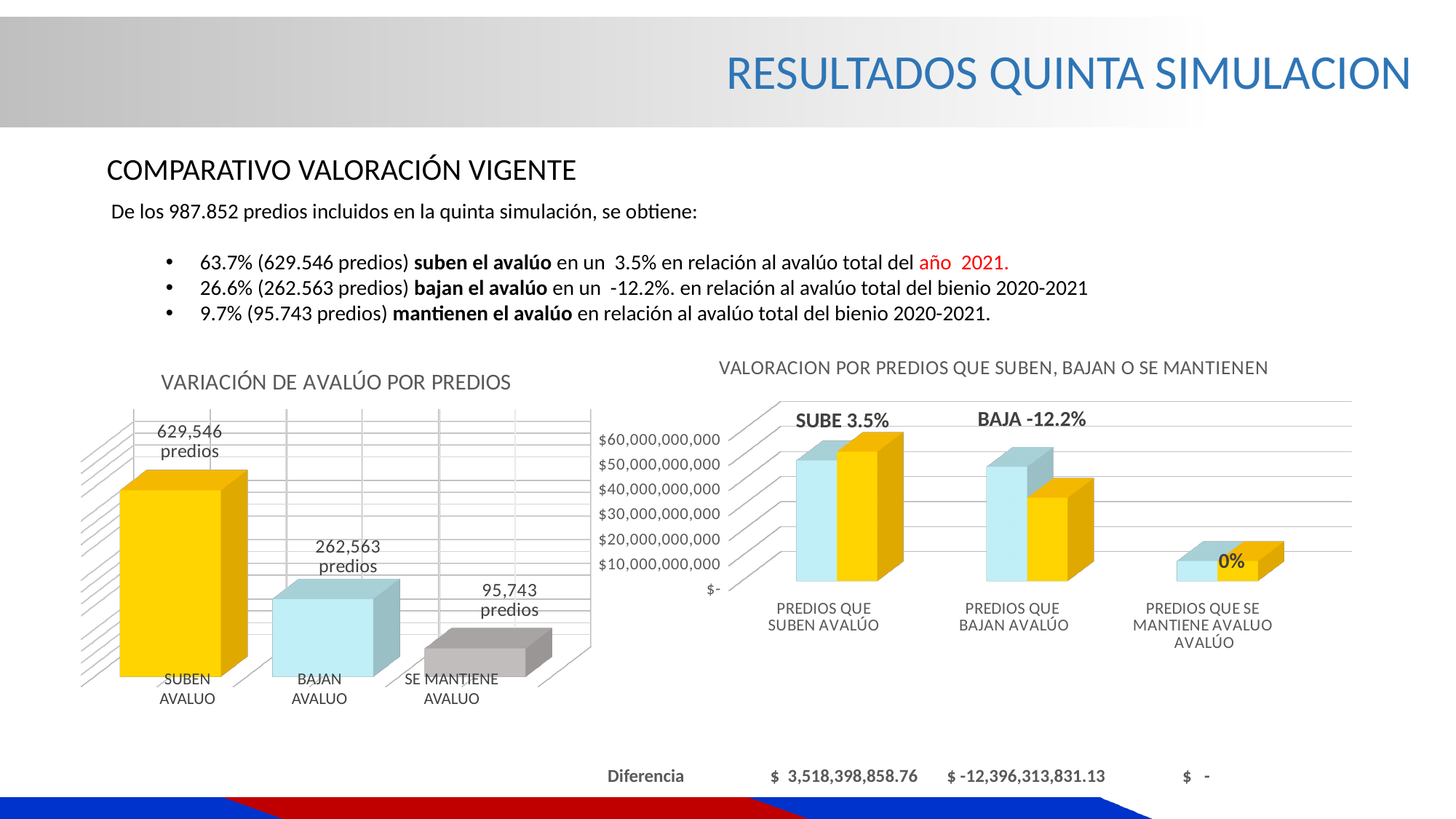
What kind of chart is the one titled "VARIACIÓN DE AVALÚO POR PREDIOS"? Bar chart In the chart titled "VARIACIÓN DE AVALÚO POR PREDIOS", which category has the highest value? SUBEN AVALUO In the chart titled "VALORACION POR PREDIOS QUE SUBEN, BAJAN O SE MANTIENEN", is the value of the yellow bar for PREDIOS QUE BAJAN AVALÚO greater or less than $40,000,000,000? less In the chart titled "VALORACION POR PREDIOS QUE SUBEN, BAJAN O SE MANTIENEN", is the value of the light blue bar for PREDIOS QUE SUBEN AVALÚO greater or less than $40,000,000,000? greater In the chart titled "VARIACIÓN DE AVALÚO POR PREDIOS", what is the difference between SUBEN AVALUO and BAJAN AVALUO? 366,983 predios In the chart titled "VARIACIÓN DE AVALÚO POR PREDIOS", which category has the lowest value? SE MANTIENE AVALUO In the chart titled "VALORACION POR PREDIOS QUE SUBEN, BAJAN O SE MANTIENEN", which category has the lowest values? PREDIOS QUE SE MANTIENE AVALUO AVALÚO In the chart titled "VARIACIÓN DE AVALÚO POR PREDIOS", what is the value for SUBEN AVALUO? 629,546 predios In the chart titled "VALORACION POR PREDIOS QUE SUBEN, BAJAN O SE MANTIENEN", what percentage label is shown above the PREDIOS QUE BAJAN AVALÚO bars? BAJA -12.2% In the chart titled "VARIACIÓN DE AVALÚO POR PREDIOS", what is the value for BAJAN AVALUO? 262,563 predios In the chart titled "VARIACIÓN DE AVALÚO POR PREDIOS", how many categories are shown? 3 In the chart titled "VARIACIÓN DE AVALÚO POR PREDIOS", what is the value for SE MANTIENE AVALUO? 95,743 predios